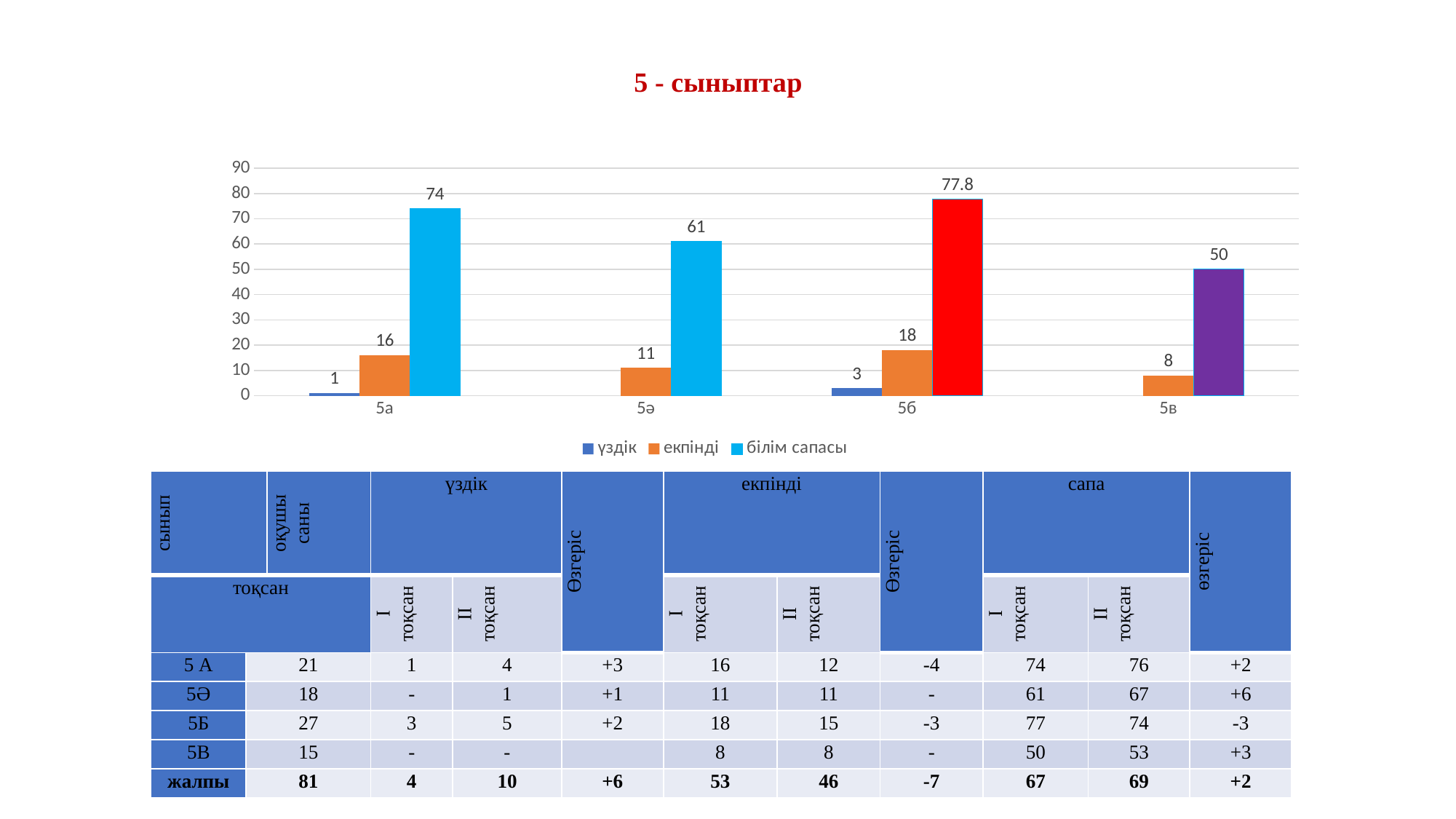
Which is larger, the екпінді value for 5а or for 5ә? 5а What is the value of білім сапасы for 5а? 74 How many categories are shown on the x axis of the chart? 4 What is the difference between the білім сапасы values for 5а and 5ә? 13 What is the value of екпінді for 5б? 18 What is the value of үздік for 5а? 1 Which category has the highest білім сапасы value? 5б What kind of chart is shown on the slide? bar chart Is the білім сапасы value for 5в greater or less than 60? less How many series does the chart legend list? 3 Which category has the lowest білім сапасы value? 5в What is the value of білім сапасы for 5б? 77.8